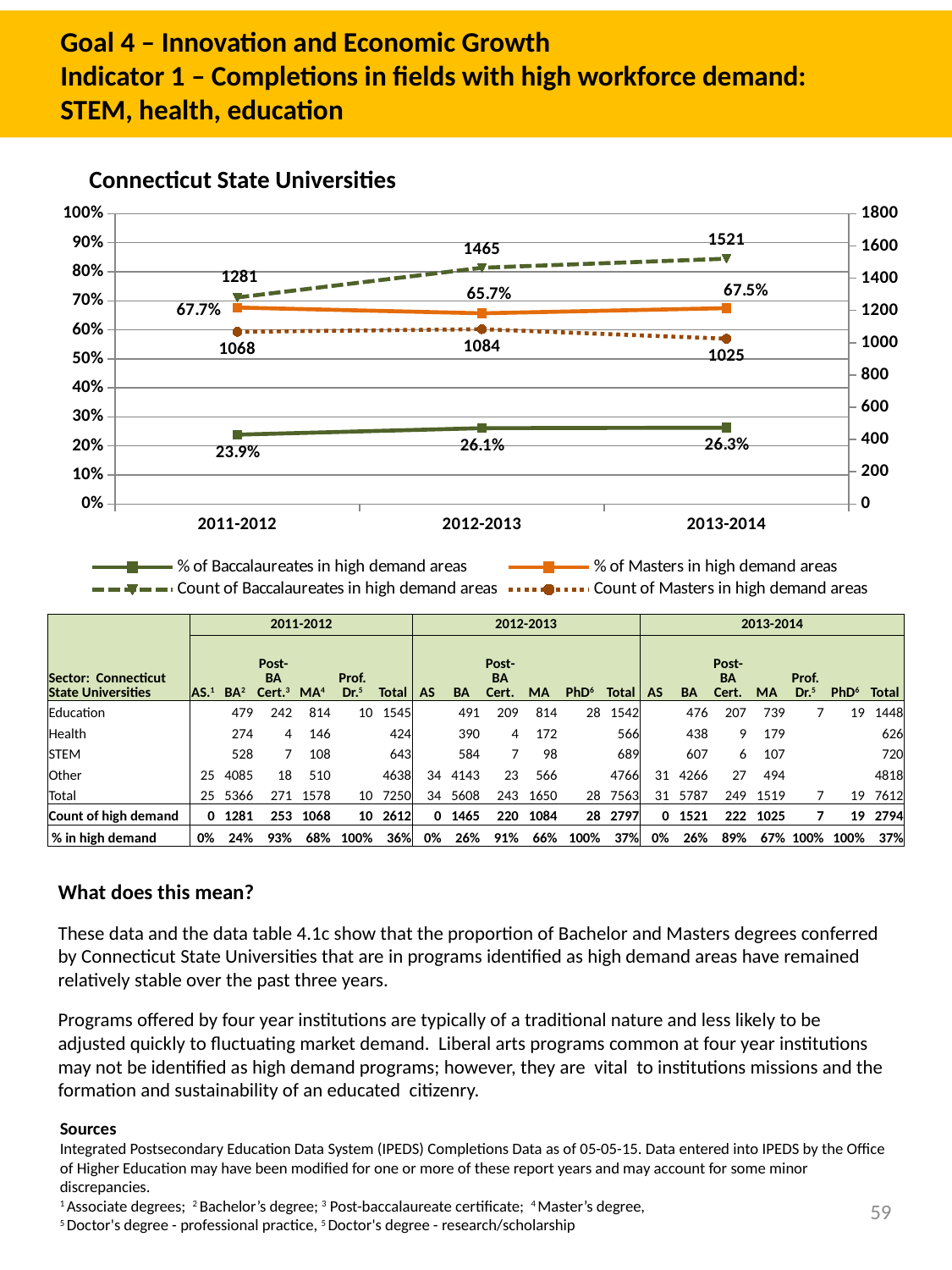
How many series does the chart legend list? 4 Which is larger in 2011-2012: the Count of Baccalaureates in high demand areas or the Count of Masters in high demand areas? Count of Baccalaureates in high demand areas In which year is the Count of Masters in high demand areas lowest? 2013-2014 What is the value for % of Baccalaureates in high demand areas in 2011-2012? 23.9% What is the difference between the Count of Baccalaureates in high demand areas in 2013-2014 and in 2011-2012? 240 What is the Count of Baccalaureates in high demand areas in 2013-2014? 1521 What is the value for % of Masters in high demand areas in 2012-2013? 65.7% How many years are shown on the x axis of the chart? 3 In which year is the Count of Baccalaureates in high demand areas highest? 2013-2014 Does the % of Baccalaureates in high demand areas rise or fall from 2011-2012 to 2013-2014? Rise What kind of chart is shown on the slide? Line chart What is the Count of Masters in high demand areas in 2012-2013? 1084